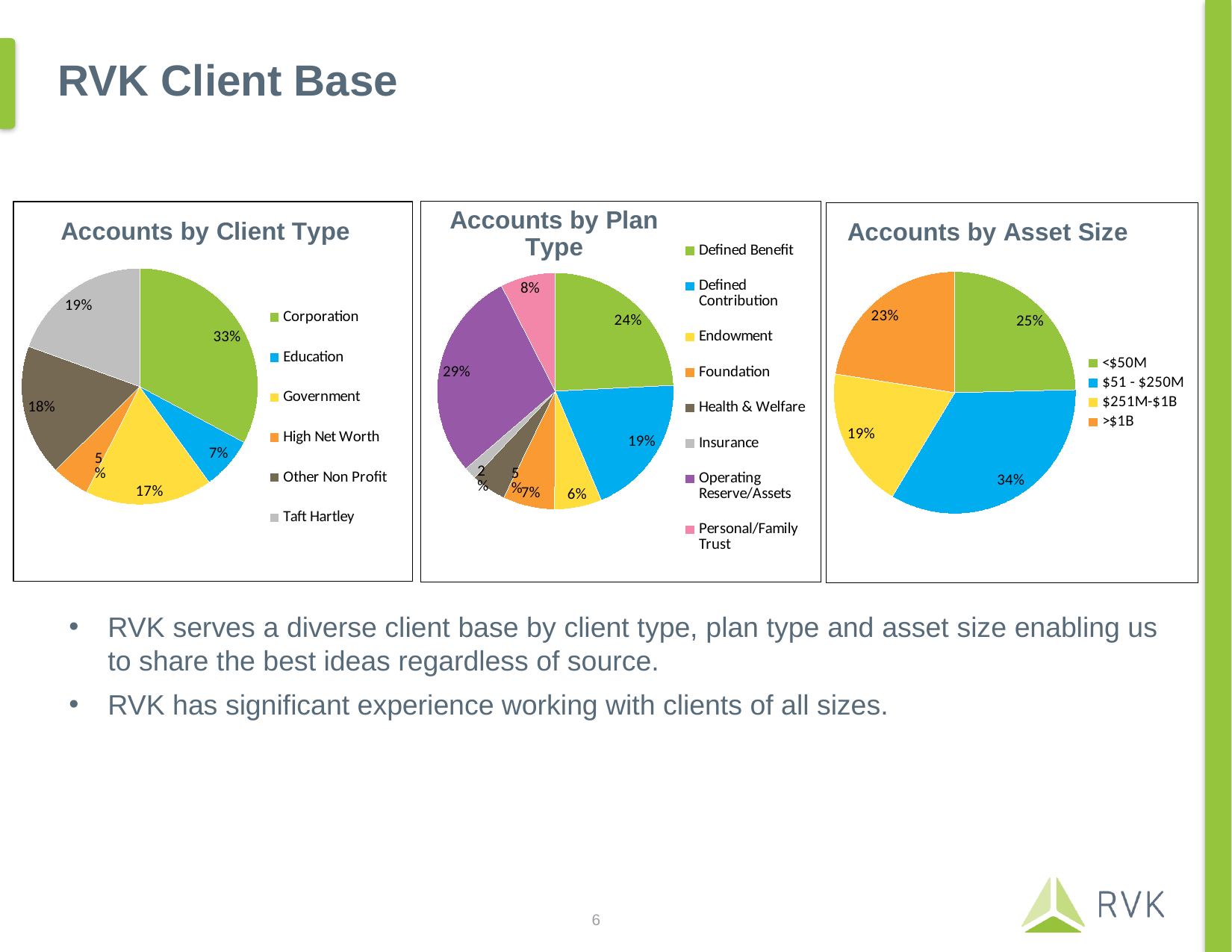
In the Accounts by Plan Type chart, how many plan types are listed in the legend? 8 In the Accounts by Asset Size chart, which asset size category has the largest share? $51 - $250M In the Accounts by Asset Size chart, what is the difference between the <$50M share and the $251M-$1B share? 6% In the Accounts by Client Type chart, which client type has the smallest share? High Net Worth In the Accounts by Client Type chart, how many client types are shown in the legend? 6 In the Accounts by Client Type chart, what share of accounts is Corporation? 33% What type of chart is used for Accounts by Asset Size? Pie chart In the Accounts by Plan Type chart, which is larger, Endowment or Foundation? Foundation In the Accounts by Client Type chart, what is the difference between the Taft Hartley share and the Other Non Profit share? 1% In the Accounts by Plan Type chart, what share of accounts is Defined Contribution? 19% In the Accounts by Plan Type chart, which plan type has the largest share? Operating Reserve/Assets In the Accounts by Plan Type chart, what share of accounts is Insurance? 2%